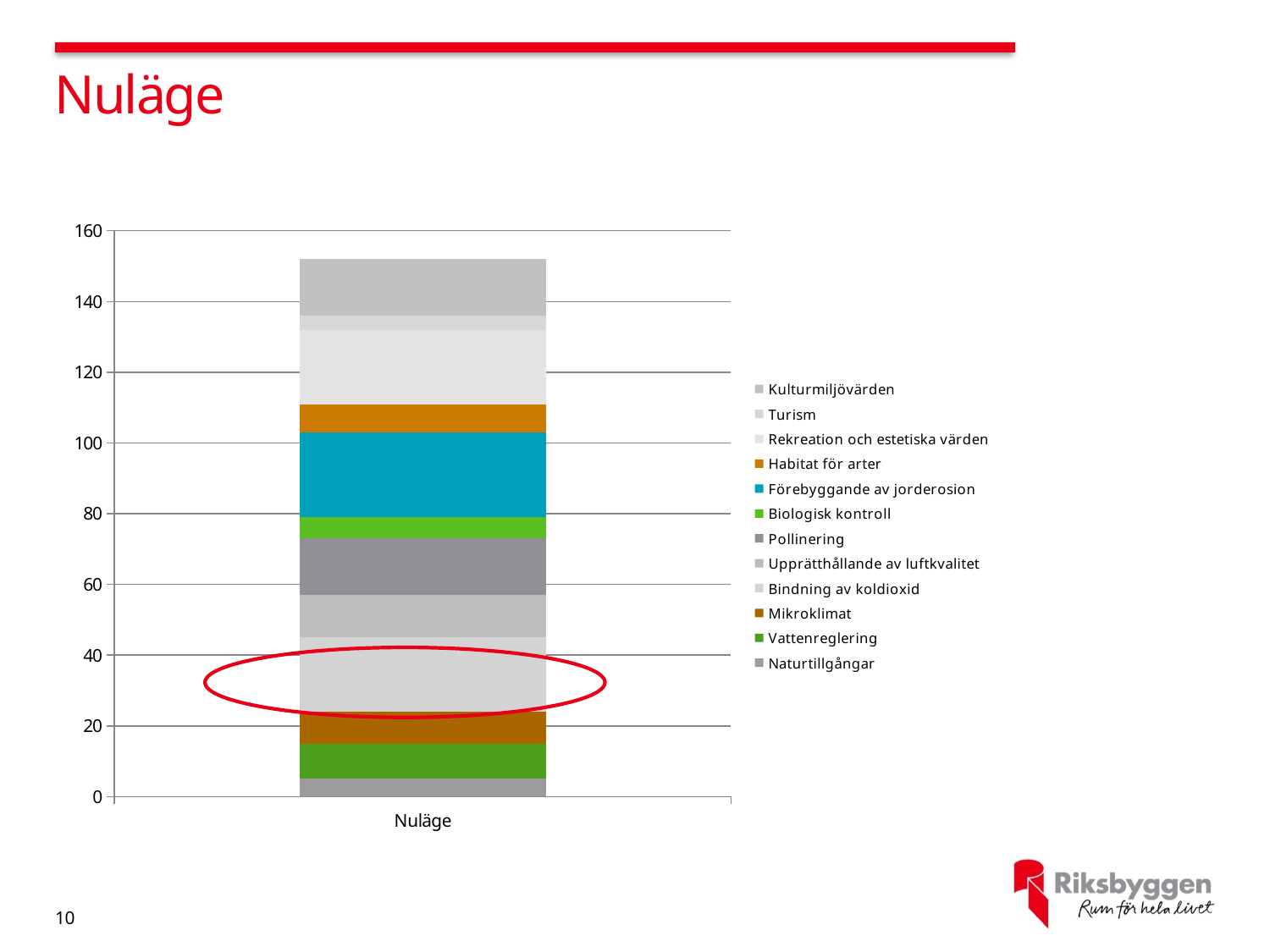
How many series does the legend list? 12 Which segment is larger: Förebyggande av jorderosion or Biologisk kontroll? Förebyggande av jorderosion Is the total height of the stacked bar greater or less than 140? greater Which series is at the bottom of the stacked bar? Naturtillgångar What kind of chart is shown on the slide? Stacked bar chart Is the total height of the stacked bar greater or less than 160? less How many categories are plotted on the x axis? 1 Which segment is larger: Pollinering or Turism? Pollinering What is the label of the single category on the x axis? Nuläge What is the highest value shown on the y axis? 160 Which segment is larger: Rekreation och estetiska värden or Habitat för arter? Rekreation och estetiska värden Which series is at the top of the stacked bar? Kulturmiljövärden